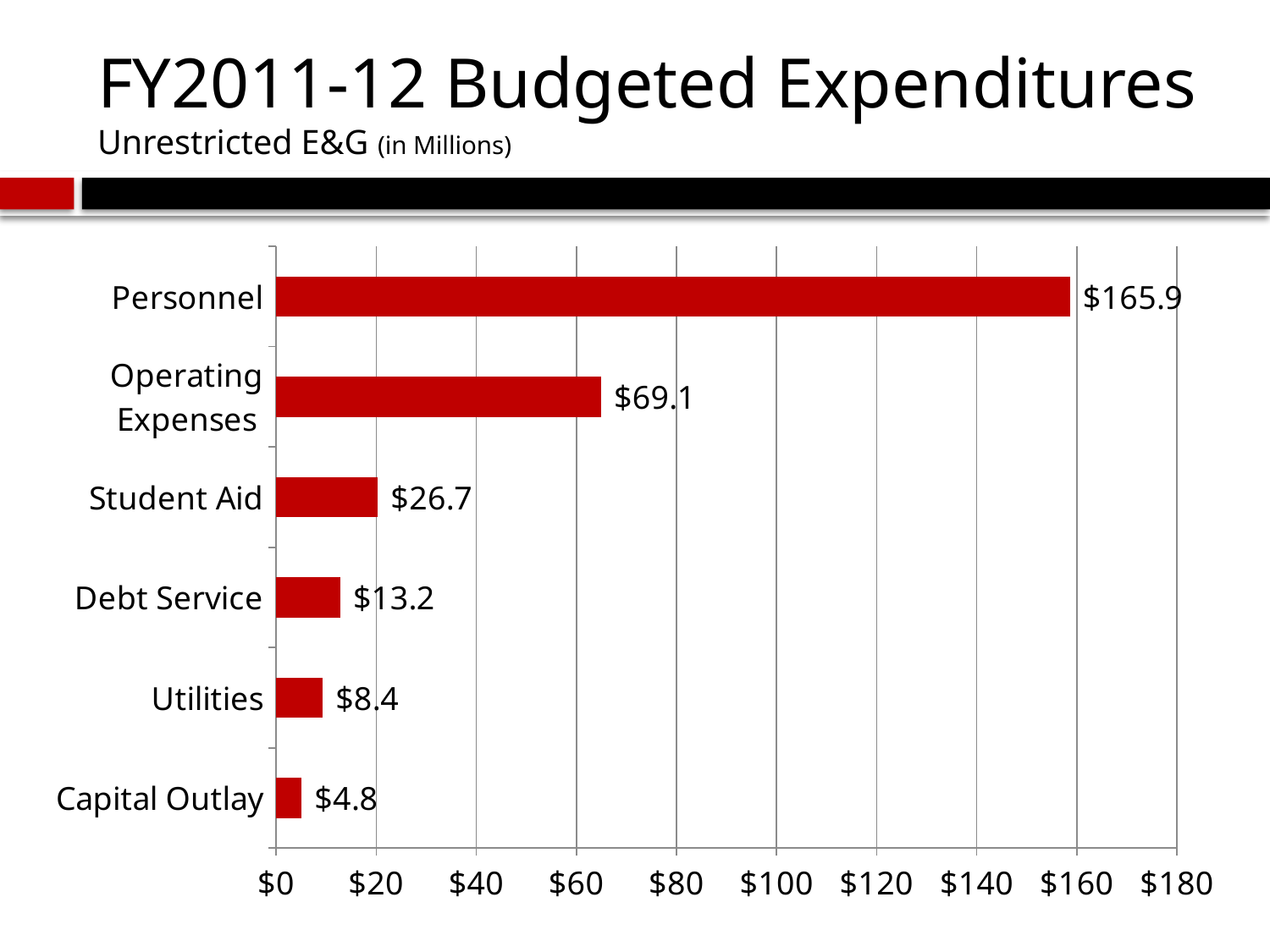
What is the difference between the Student Aid and Debt Service values? $13.5 Which category has the lowest budgeted expenditure? Capital Outlay Which is larger, Student Aid or Utilities? Student Aid How many expenditure categories are shown in the chart? 6 What is the value shown for Utilities? $8.4 What is the budgeted expenditure for Personnel? $165.9 What kind of chart is shown on the slide? Bar chart What is the title of the slide? FY2011-12 Budgeted Expenditures What is the value shown for Operating Expenses? $69.1 What is the difference between the Personnel and Operating Expenses values? $96.8 What is the value shown for Debt Service? $13.2 Which category has the highest budgeted expenditure? Personnel